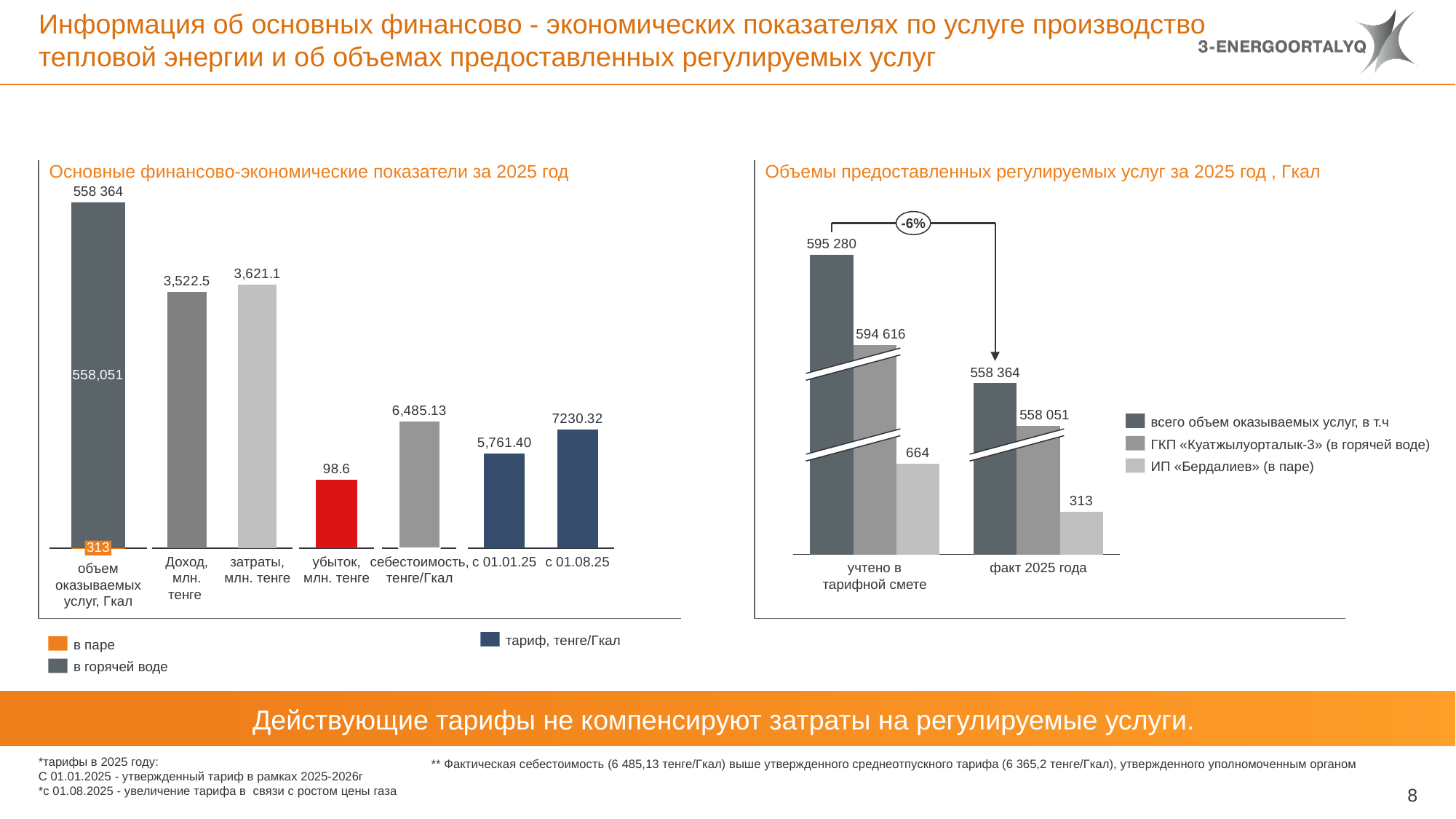
On the chart 'Объемы предоставленных регулируемых услуг за 2025 год, Гкал', what percentage change is annotated between 'учтено в тарифной смете' and 'факт 2025 года'? -6% On the chart 'Основные финансово-экономические показатели за 2025 год', what is the value for 'Доход, млн. тенге'? 3,522.5 What kind of chart is 'Объемы предоставленных регулируемых услуг за 2025 год, Гкал'? bar chart On the chart 'Объемы предоставленных регулируемых услуг за 2025 год, Гкал', what is the value of 'всего объем оказываемых услуг' for 'учтено в тарифной смете'? 595 280 On the chart 'Основные финансово-экономические показатели за 2025 год', what is the tariff value for 'с 01.01.25'? 5,761.40 On the chart 'Объемы предоставленных регулируемых услуг за 2025 год, Гкал', what is the value of 'ИП «Бердалиев» (в паре)' for 'факт 2025 года'? 313 On the chart 'Основные финансово-экономические показатели за 2025 год', what is the value for 'себестоимость, тенге/Гкал'? 6,485.13 On the chart 'Объемы предоставленных регулируемых услуг за 2025 год, Гкал', what is the difference between 'ИП «Бердалиев» (в паре)' for 'учтено в тарифной смете' and for 'факт 2025 года'? 351 On the chart 'Основные финансово-экономические показатели за 2025 год', which tariff is larger: 'с 01.01.25' or 'с 01.08.25'? с 01.08.25 On the chart 'Основные финансово-экономические показатели за 2025 год', what is the value for 'затраты, млн. тенге'? 3,621.1 On the chart 'Основные финансово-экономические показатели за 2025 год', what is the value for 'убыток, млн. тенге'? 98.6 On the chart 'Объемы предоставленных регулируемых услуг за 2025 год, Гкал', how many series does the legend list? 3